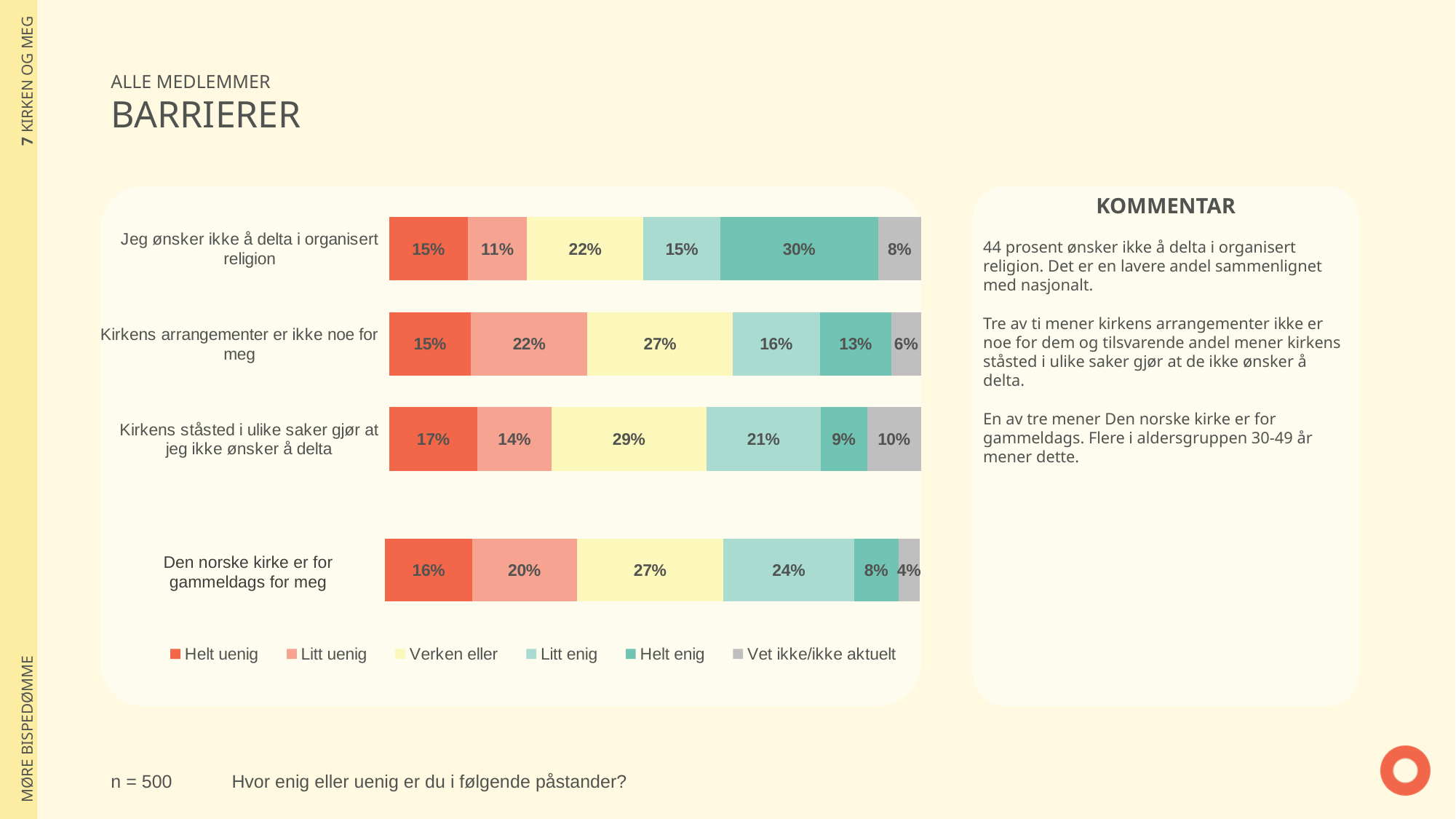
What percentage answered "Helt enig" to the statement "Jeg ønsker ikke å delta i organisert religion"? 30% What is the sample size (n) stated on the slide? n = 500 What is the combined share of "Helt uenig" and "Litt uenig" for "Jeg ønsker ikke å delta i organisert religion"? 26% Which statement has the lowest "Vet ikke/ikke aktuelt" share? Den norske kirke er for gammeldags for meg What kind of chart is shown on the slide? Stacked bar chart Which statement has the larger "Litt enig" share: "Kirkens ståsted i ulike saker gjør at jeg ikke ønsker å delta" or "Kirkens arrangementer er ikke noe for meg"? Kirkens ståsted i ulike saker gjør at jeg ikke ønsker å delta What is the "Verken eller" share for "Kirkens ståsted i ulike saker gjør at jeg ikke ønsker å delta"? 29% How many percentage points higher is the "Litt uenig" share for "Kirkens arrangementer er ikke noe for meg" than for "Jeg ønsker ikke å delta i organisert religion"? 11 percentage points What percentage answered "Litt enig" to "Den norske kirke er for gammeldags for meg"? 24% How many statements are shown in the chart? 4 How many response categories does the legend list? 6 Which statement has the highest "Helt enig" share? Jeg ønsker ikke å delta i organisert religion